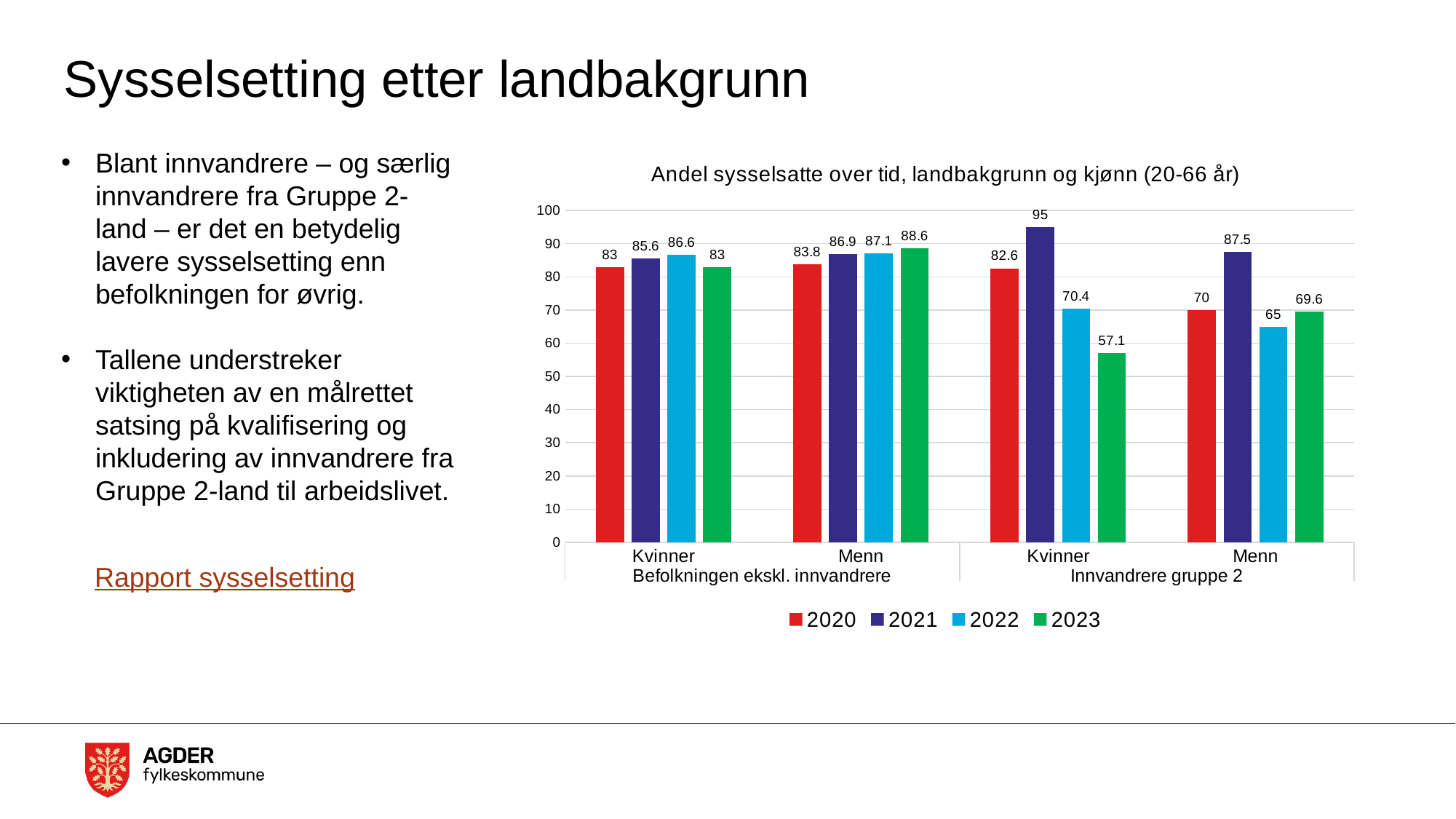
What is the title of the chart? Andel sysselsatte over tid, landbakgrunn og kjønn (20-66 år) What kind of chart is shown on the slide? Bar chart What is the 2020 value for Menn in the Innvandrere gruppe 2 group? 70 Which bar has the lowest value in the chart? 2023, Kvinner, Innvandrere gruppe 2 How many series does the legend list? 4 Do the values for Menn in the Befolkningen ekskl. innvandrere group rise or fall from 2020 to 2023? Rise What is the 2023 value for Kvinner in the Innvandrere gruppe 2 group? 57.1 Which bar has the highest value in the chart? 2021, Kvinner, Innvandrere gruppe 2 What is the 2021 value for Kvinner in the Innvandrere gruppe 2 group? 95 What is the 2022 value for Menn in the Befolkningen ekskl. innvandrere group? 87.1 What is the difference between the 2021 and 2023 values for Kvinner in the Innvandrere gruppe 2 group? 37.9 Which is larger: the 2023 value for Menn in Befolkningen ekskl. innvandrere or the 2023 value for Menn in Innvandrere gruppe 2? Menn in Befolkningen ekskl. innvandrere (88.6)